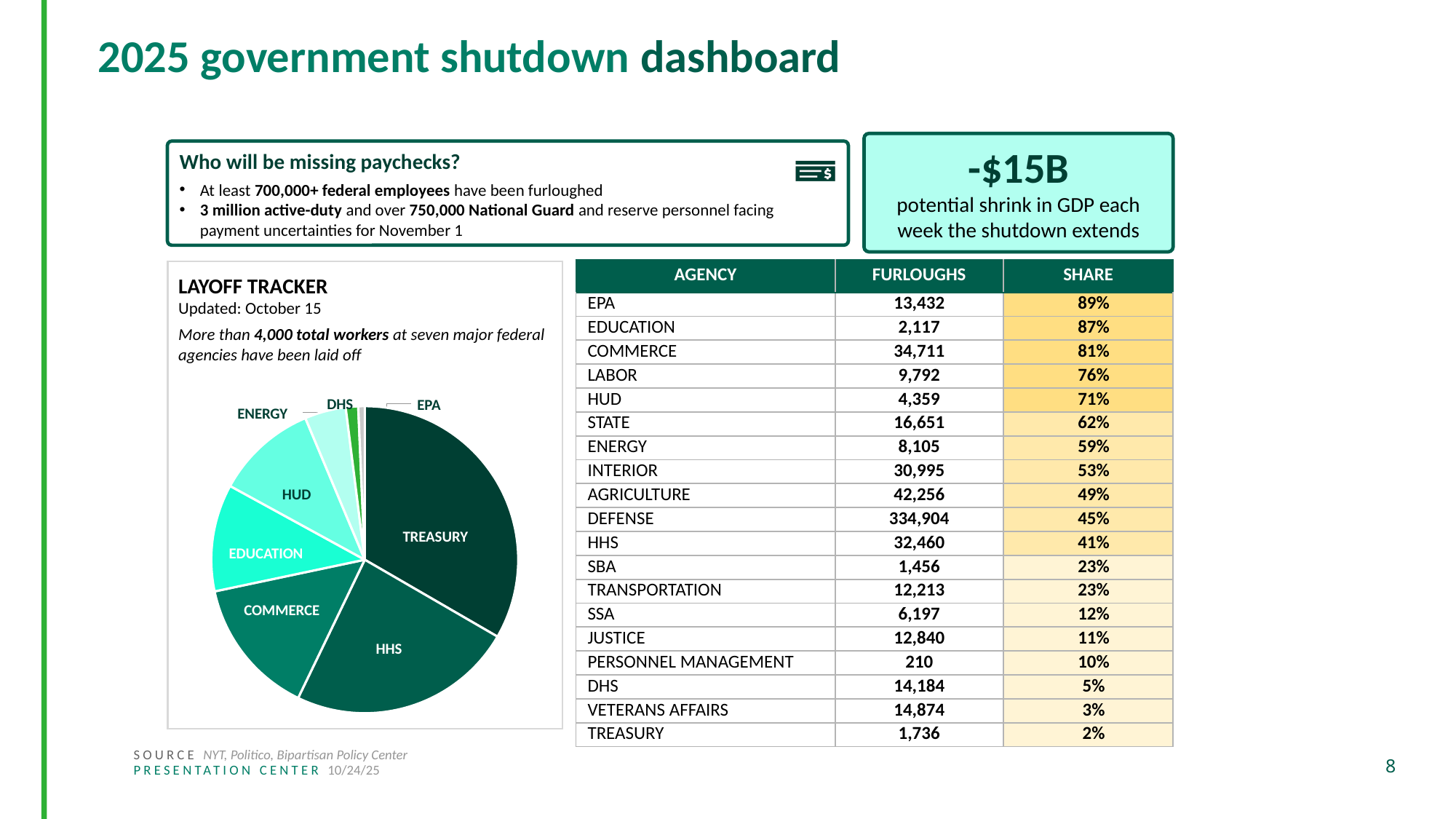
In the Layoff Tracker pie chart, which slice is larger, EDUCATION or HUD? EDUCATION What kind of chart is the Layoff Tracker chart? pie chart In the Layoff Tracker pie chart, which slice is larger, TREASURY or HHS? TREASURY What update date is shown for the Layoff Tracker pie chart? October 15 In the Layoff Tracker pie chart, which agency has the largest slice? TREASURY In the Layoff Tracker pie chart, which slice is larger, COMMERCE or ENERGY? COMMERCE What is the title of the pie chart on the slide? LAYOFF TRACKER